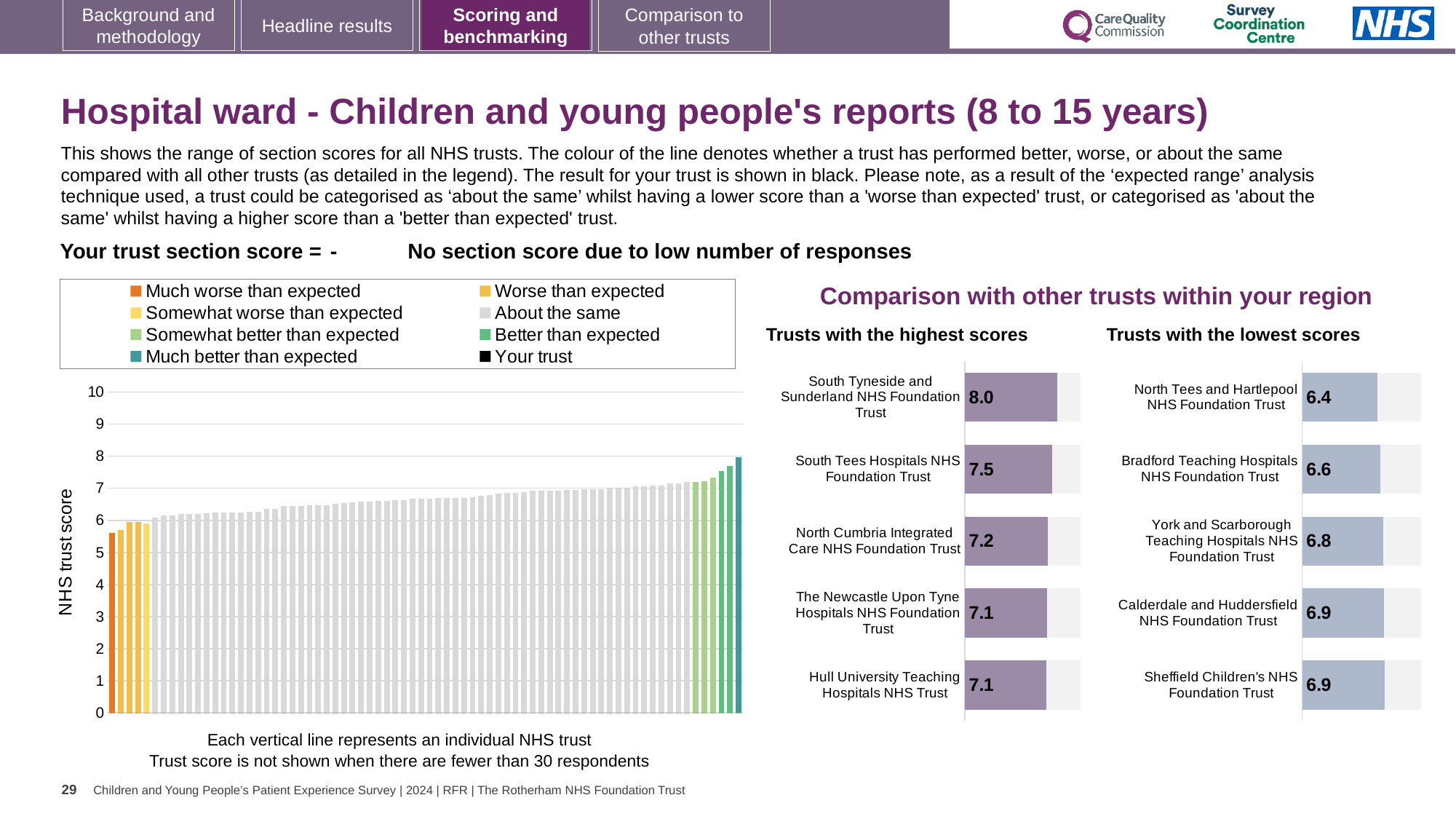
In the 'Trusts with the highest scores' chart, which trust has the highest score? South Tyneside and Sunderland NHS Foundation Trust In the 'Trusts with the lowest scores' chart, what is the difference between the scores of York and Scarborough Teaching Hospitals NHS Foundation Trust and North Tees and Hartlepool NHS Foundation Trust? 0.4 In the 'Trusts with the highest scores' chart, what is the difference between the scores of South Tyneside and Sunderland NHS Foundation Trust and South Tees Hospitals NHS Foundation Trust? 0.5 In the large chart on the left, do the NHS trust scores rise or fall from left to right? Rise In the 'Trusts with the lowest scores' chart, what is the score for Bradford Teaching Hospitals NHS Foundation Trust? 6.6 In the 'Trusts with the highest scores' chart, what is the score for South Tyneside and Sunderland NHS Foundation Trust? 8.0 How many entries does the legend above the large chart on the left list? 8 What kind of chart is the large chart on the left showing NHS trust scores? Bar chart In the 'Trusts with the highest scores' chart, what is the score for North Cumbria Integrated Care NHS Foundation Trust? 7.2 In the 'Trusts with the lowest scores' chart, which trust has the lowest score? North Tees and Hartlepool NHS Foundation Trust Which is larger: the score for Hull University Teaching Hospitals NHS Trust in the highest scores chart or the score for Sheffield Children's NHS Foundation Trust in the lowest scores chart? Hull University Teaching Hospitals NHS Trust How many trusts are listed in the 'Trusts with the lowest scores' chart? 5